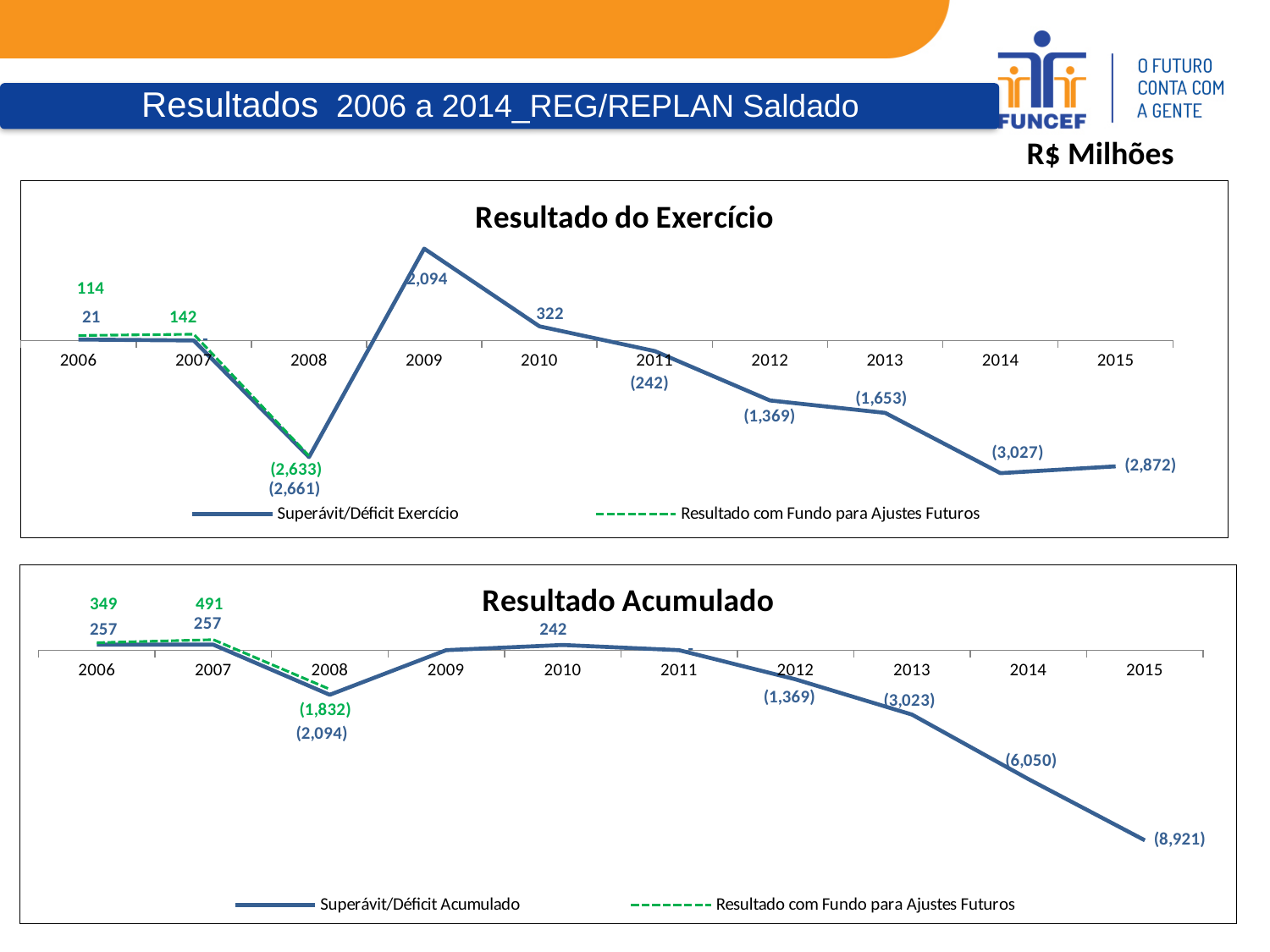
In the 'Resultado Acumulado' chart, how many series does the legend list? 2 In the 'Resultado Acumulado' chart, which year has the lowest value of Superávit/Déficit Acumulado? 2015 In the 'Resultado do Exercício' chart, what is the value of Superávit/Déficit Exercício for 2014? (3,027) In the 'Resultado do Exercício' chart, what is the value of Resultado com Fundo para Ajustes Futuros for 2006? 114 In the 'Resultado Acumulado' chart, is the Superávit/Déficit Acumulado value for 2013 larger or smaller than the value for 2014? larger What type of chart is 'Resultado Acumulado'? line chart In the 'Resultado do Exercício' chart, what is the value of Superávit/Déficit Exercício for 2009? 2,094 In the 'Resultado Acumulado' chart, what is the value of Resultado com Fundo para Ajustes Futuros for 2007? 491 In the 'Resultado do Exercício' chart, which year has the lowest value of Superávit/Déficit Exercício? 2014 In the 'Resultado Acumulado' chart, what is the value of Superávit/Déficit Acumulado for 2015? (8,921) In the 'Resultado do Exercício' chart, which year has the highest value of Superávit/Déficit Exercício? 2009 In the 'Resultado do Exercício' chart, how many years are shown on the x axis? 10